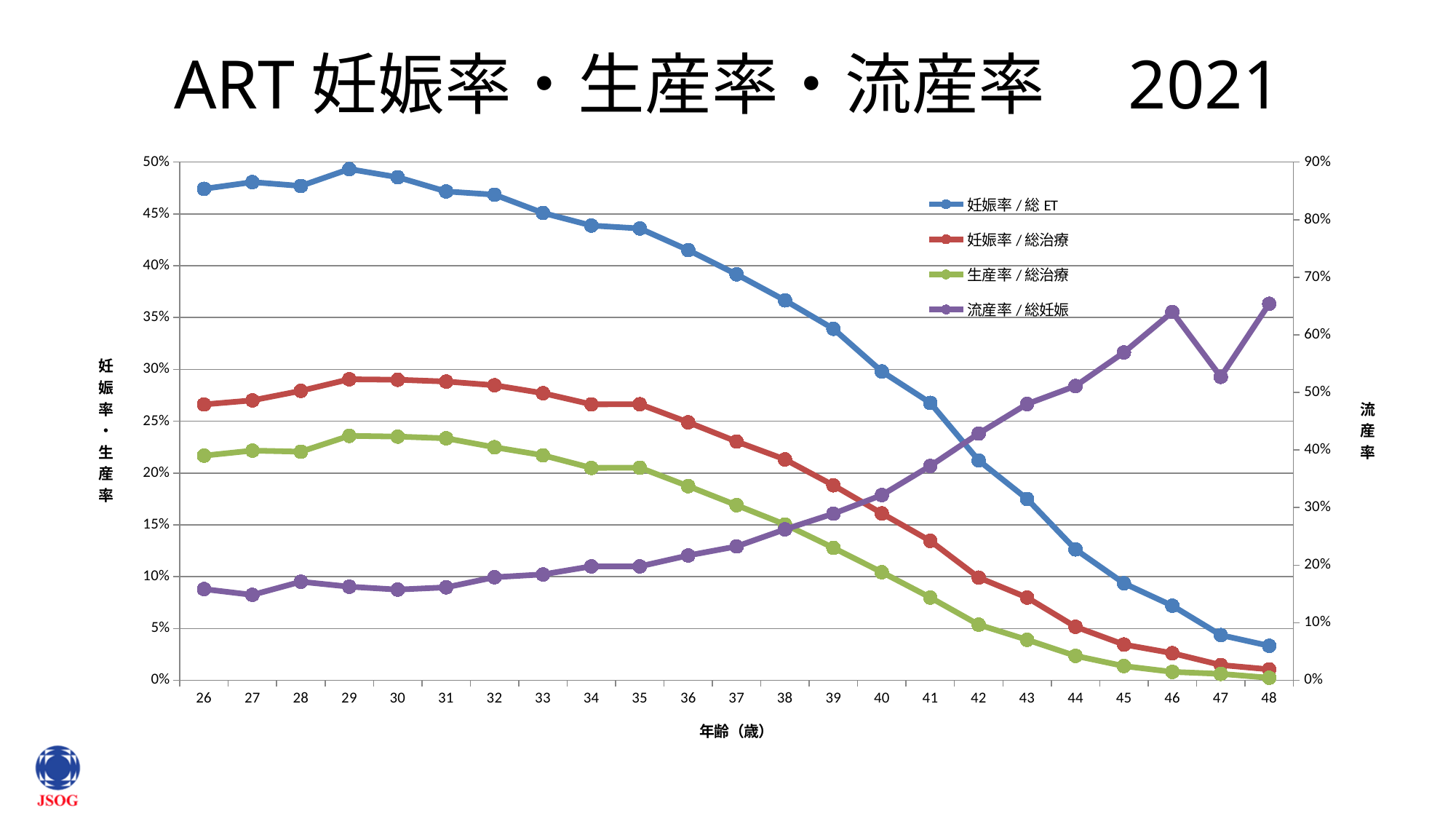
Does the 流産率 / 総妊娠 series rise or fall overall as age increases along the x axis? rise At age 45, which is larger: 妊娠率 / 総治療 or 生産率 / 総治療? 妊娠率 / 総治療 Is the value of 流産率 / 総妊娠 at age 46 greater or less than 60% on the right axis? greater What is the title of the chart on the slide? ART 妊娠率・生産率・流産率 2021 What kind of chart is shown on the slide? line chart Is the value of 生産率 / 総治療 at age 29 greater or less than 20%? greater Is the value of 妊娠率 / 総 ET at age 43 greater or less than 20%? less How many series does the legend list? 4 At which age is the 妊娠率 / 総 ET series lowest? 48 Does the 妊娠率 / 総 ET series rise or fall overall as age increases along the x axis? fall How many age points are plotted along the x axis? 23 At which age is the 妊娠率 / 総 ET series highest? 29